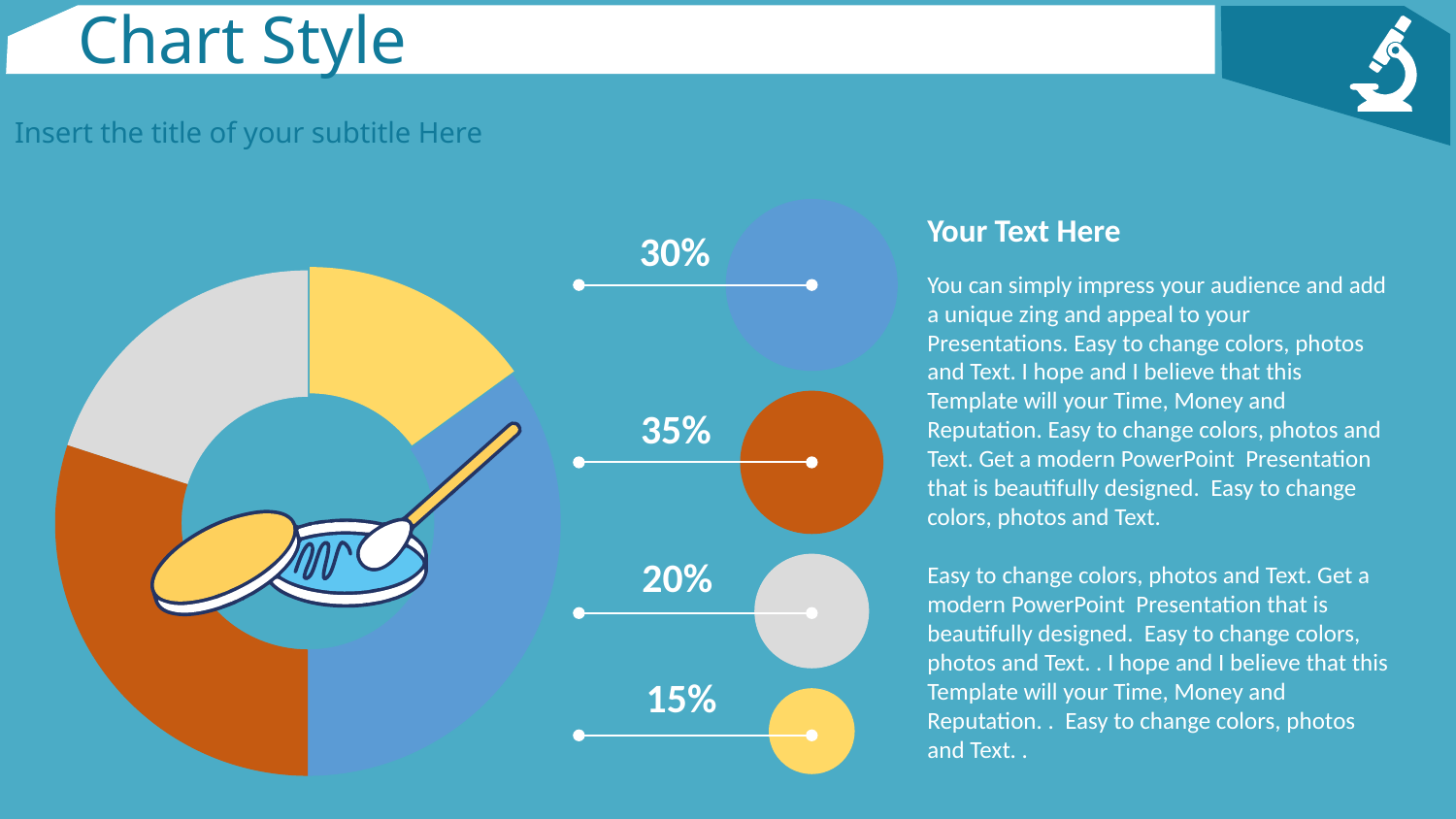
What is the difference between the orange segment's share and the yellow segment's share? 20% Which is larger, the blue segment or the grey segment? Blue What do the four percentages in the legend add up to? 100% What percentage is shown for the blue segment? 30% Which colour segment has the smallest share? Yellow How many segments does the donut chart have? 4 What percentage is shown for the grey segment? 20% What percentage is shown for the orange segment? 35% What is the title of the slide? Chart Style Which colour segment has the largest share? Orange What percentage is shown for the yellow segment? 15% What kind of chart is shown on the slide? Donut chart